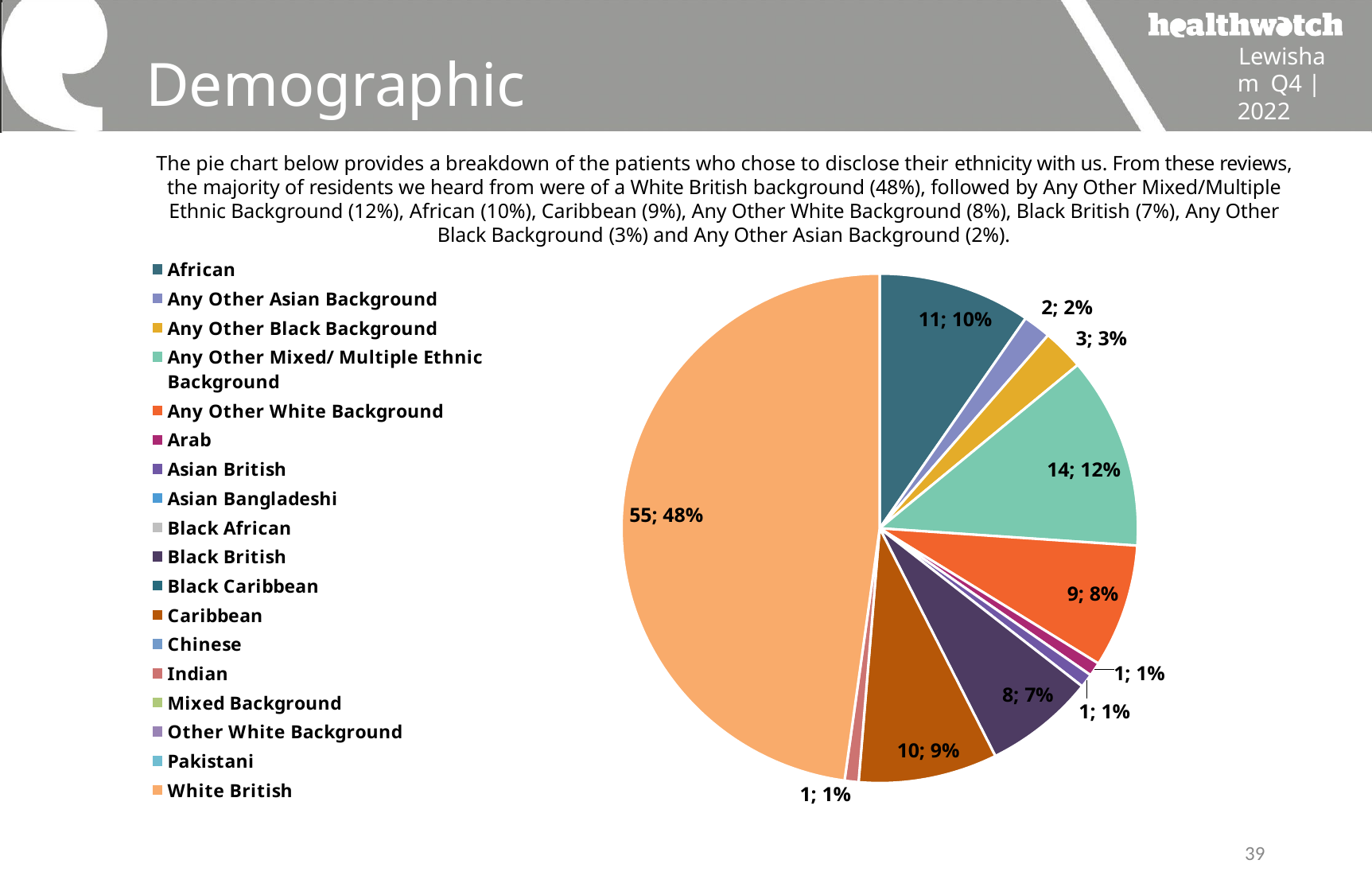
Which category has the largest slice of the pie? White British What count and share are shown for White British? 55; 48% What percentage share is shown for Any Other Black Background? 3% What count is shown for Any Other Mixed/ Multiple Ethnic Background? 14 What count and share are shown for Black British? 8; 7% What percentage share is shown for African? 10% What type of chart is shown on the slide? pie chart What is the title of the slide containing the pie chart? Demographic What is the difference in count between White British (55) and Any Other Mixed/ Multiple Ethnic Background (14)? 41 Which is larger, the slice for African or the slice for Any Other White Background? African How many categories does the legend list? 18 What percentage share is shown for Caribbean? 9%